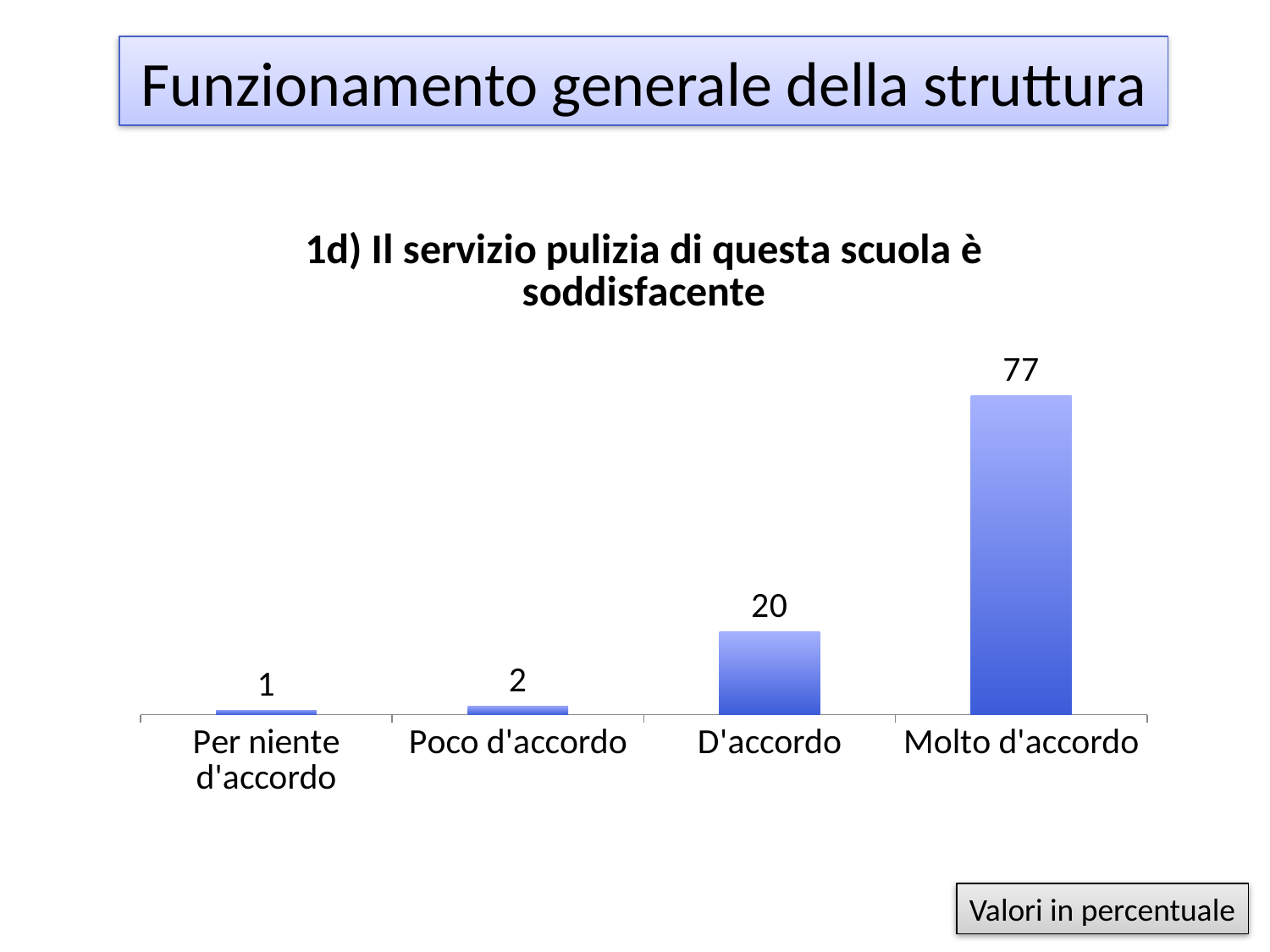
What is the difference between the values for "Molto d'accordo" and "D'accordo"? 57 What is the title of the chart? 1d) Il servizio pulizia di questa scuola è soddisfacente How many categories are shown on the x axis? 4 What is the value for "D'accordo"? 20 What is the value for "Per niente d'accordo"? 1 What kind of chart is shown on the slide? Bar chart What is the value for "Poco d'accordo"? 2 Which category has the highest value? Molto d'accordo Which category has the lowest value? Per niente d'accordo Do the values rise or fall from left to right along the x axis? Rise Which is larger, the value for "D'accordo" or the value for "Poco d'accordo"? D'accordo What is the value for "Molto d'accordo"? 77